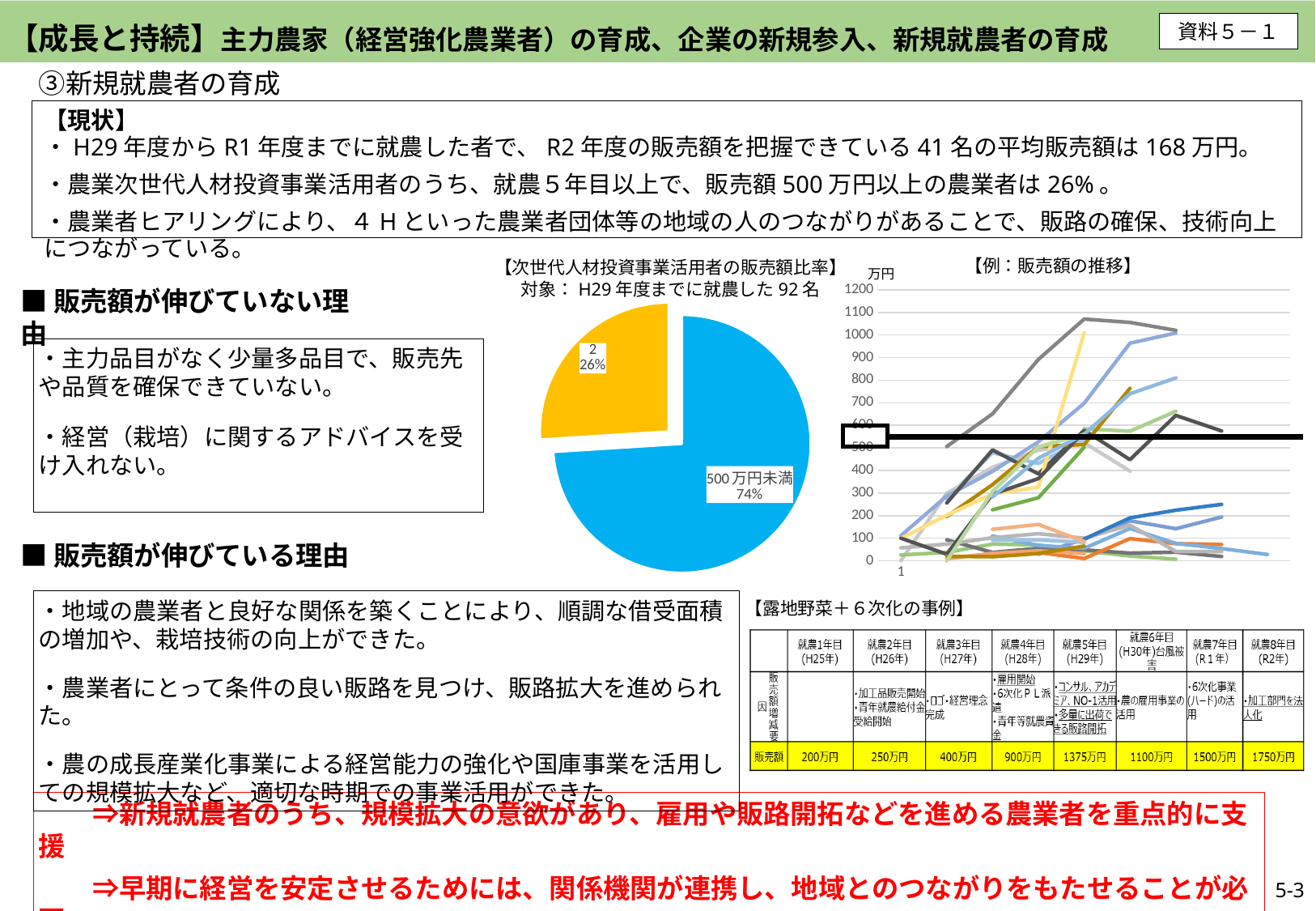
In the chart titled 【例：販売額の推移】, what is the highest value shown on the vertical axis? 1200 In the pie chart titled 【次世代人材投資事業活用者の販売額比率】, what is the difference in percentage points between the 500万円未満 slice and the 26% slice? 48 percentage points In the pie chart titled 【次世代人材投資事業活用者の販売額比率】, what percentage is shown on the yellow slice? 26% In the pie chart titled 【次世代人材投資事業活用者の販売額比率】, which slice is the largest? 500万円未満 In the pie chart titled 【次世代人材投資事業活用者の販売額比率】, is the 500万円未満 slice larger or smaller than the yellow slice? larger In the pie chart titled 【次世代人材投資事業活用者の販売額比率】, how many slices does the pie have? 2 In the pie chart titled 【次世代人材投資事業活用者の販売額比率】, what share is shown for the 500万円未満 slice? 74% According to the subtitle of the pie chart 【次世代人材投資事業活用者の販売額比率】, how many people are covered (対象)? 92名 What kind of chart is the chart titled 【次世代人材投資事業活用者の販売額比率】? pie chart What kind of chart is the chart titled 【例：販売額の推移】? line chart In the chart titled 【例：販売額の推移】, what unit is shown at the top of the vertical axis? 万円 In the pie chart titled 【次世代人材投資事業活用者の販売額比率】, which slice is the smallest? The yellow slice (26%)